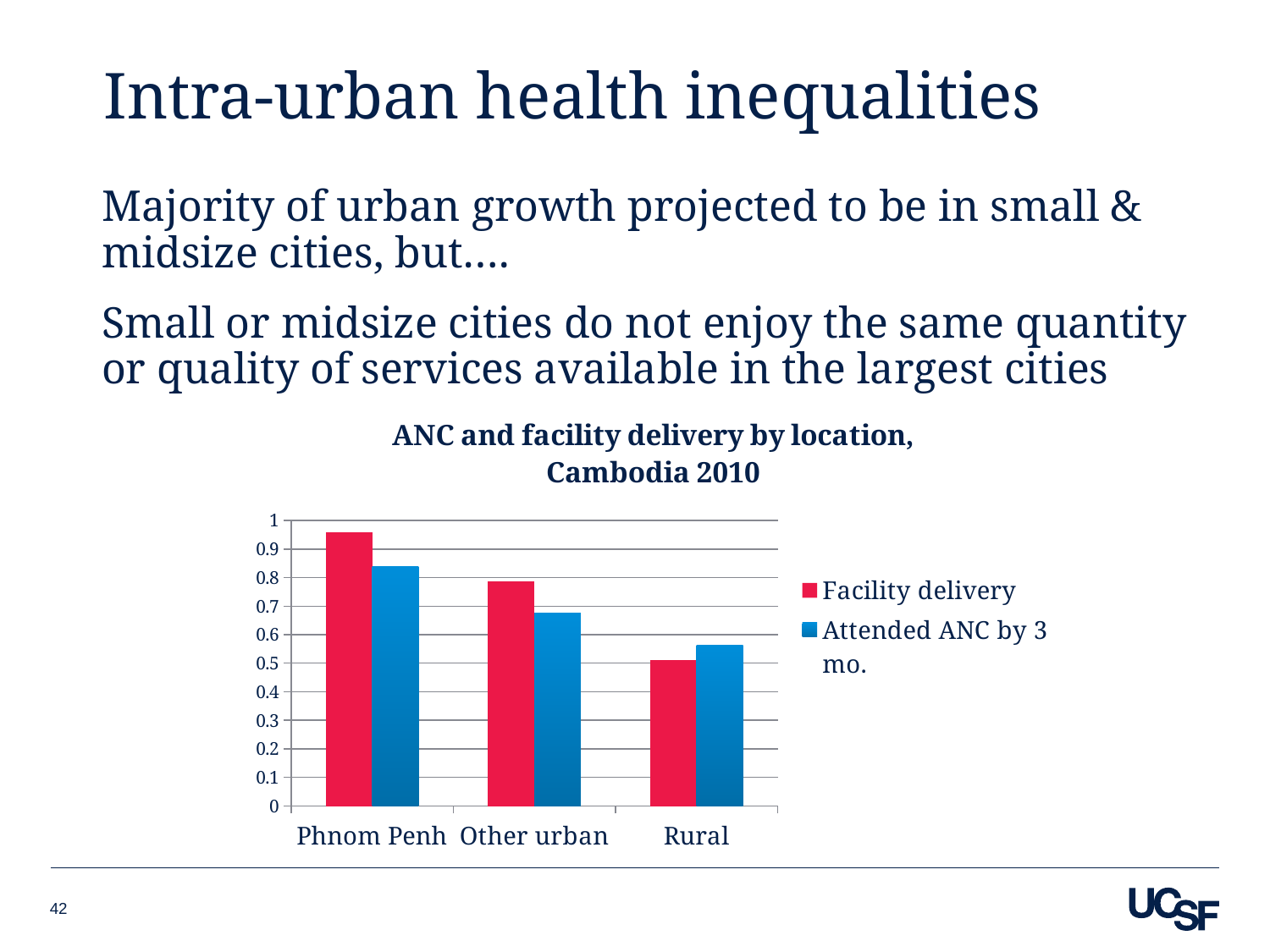
Is the Attended ANC by 3 mo. value for Other urban greater or less than 0.6? greater Is the Facility delivery value for Rural greater or less than 0.6? less How many location categories are shown on the x axis? 3 What is the title of the chart? ANC and facility delivery by location, Cambodia 2010 How many series does the chart's legend list? 2 Which location has the lowest Attended ANC by 3 mo. value? Rural What kind of chart is shown on the slide? bar chart For Other urban, which is larger: Facility delivery or Attended ANC by 3 mo.? Facility delivery For Phnom Penh, which is larger: Facility delivery or Attended ANC by 3 mo.? Facility delivery Which location has the highest Facility delivery value? Phnom Penh Is the Facility delivery value for Phnom Penh greater or less than 0.9? greater Do the Facility delivery values rise or fall moving from Phnom Penh to Rural along the x axis? fall